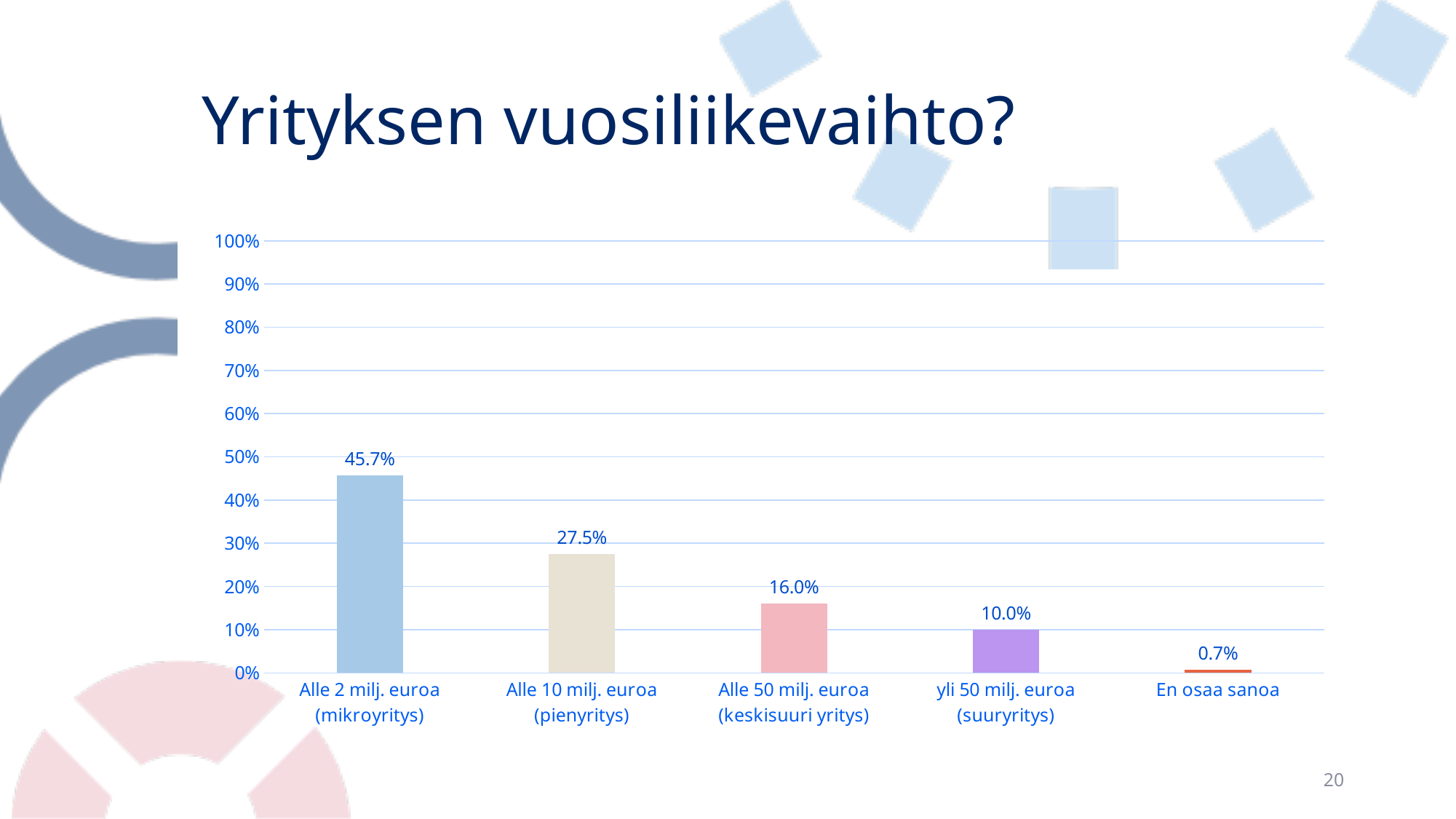
What is the value for "En osaa sanoa"? 0.7% How many categories are shown on the x axis? 5 What is the value for "Alle 2 milj. euroa (mikroyritys)"? 45.7% Which category has the lowest value? En osaa sanoa Which category has the highest value? Alle 2 milj. euroa (mikroyritys) Which is larger: the value for "Alle 50 milj. euroa (keskisuuri yritys)" or "yli 50 milj. euroa (suuryritys)"? Alle 50 milj. euroa (keskisuuri yritys) Is the value for "Alle 2 milj. euroa (mikroyritys)" greater or less than 50%? less What is the value for "Alle 50 milj. euroa (keskisuuri yritys)"? 16.0% What is the title of the slide? Yrityksen vuosiliikevaihto? What is the value for "Alle 10 milj. euroa (pienyritys)"? 27.5% What is the difference between the values for "Alle 2 milj. euroa (mikroyritys)" and "Alle 10 milj. euroa (pienyritys)"? 18.2% What kind of chart is shown on the slide? bar chart